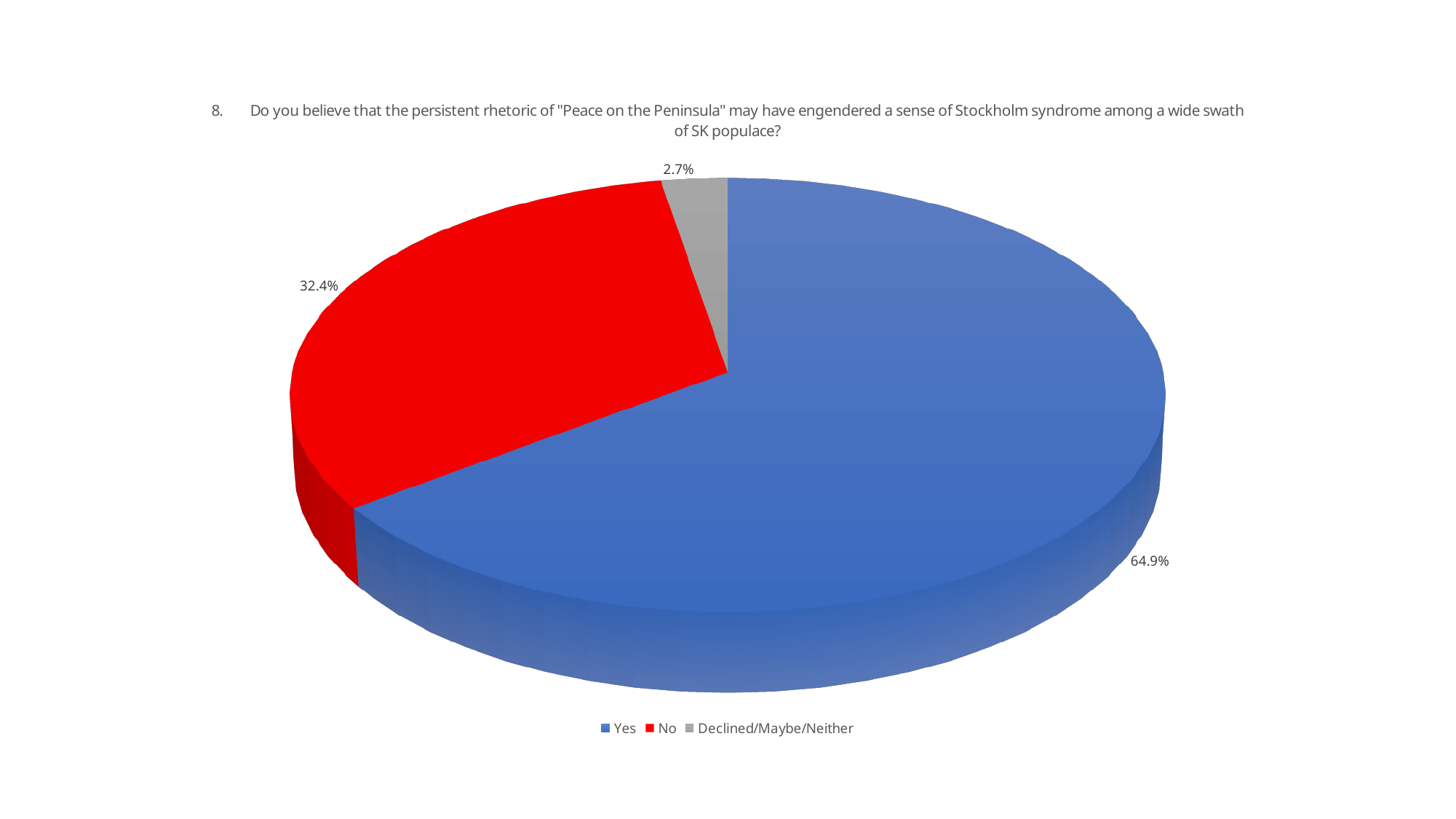
How many entries does the legend list? 3 What is the question number shown at the start of the chart title? 8 What colour is the "No" slice? red What percentage of respondents are in the "Declined/Maybe/Neither" category? 2.7% What percentage of respondents answered "No"? 32.4% What is the difference in percentage points between the "Yes" and "No" shares? 32.5 How many categories does the pie chart show? 3 Which category has the smallest share of the pie? Declined/Maybe/Neither Which is larger, the share for "No" or the share for "Declined/Maybe/Neither"? No What percentage of respondents answered "Yes"? 64.9% Which category has the largest share of the pie? Yes What kind of chart is shown on the slide? pie chart